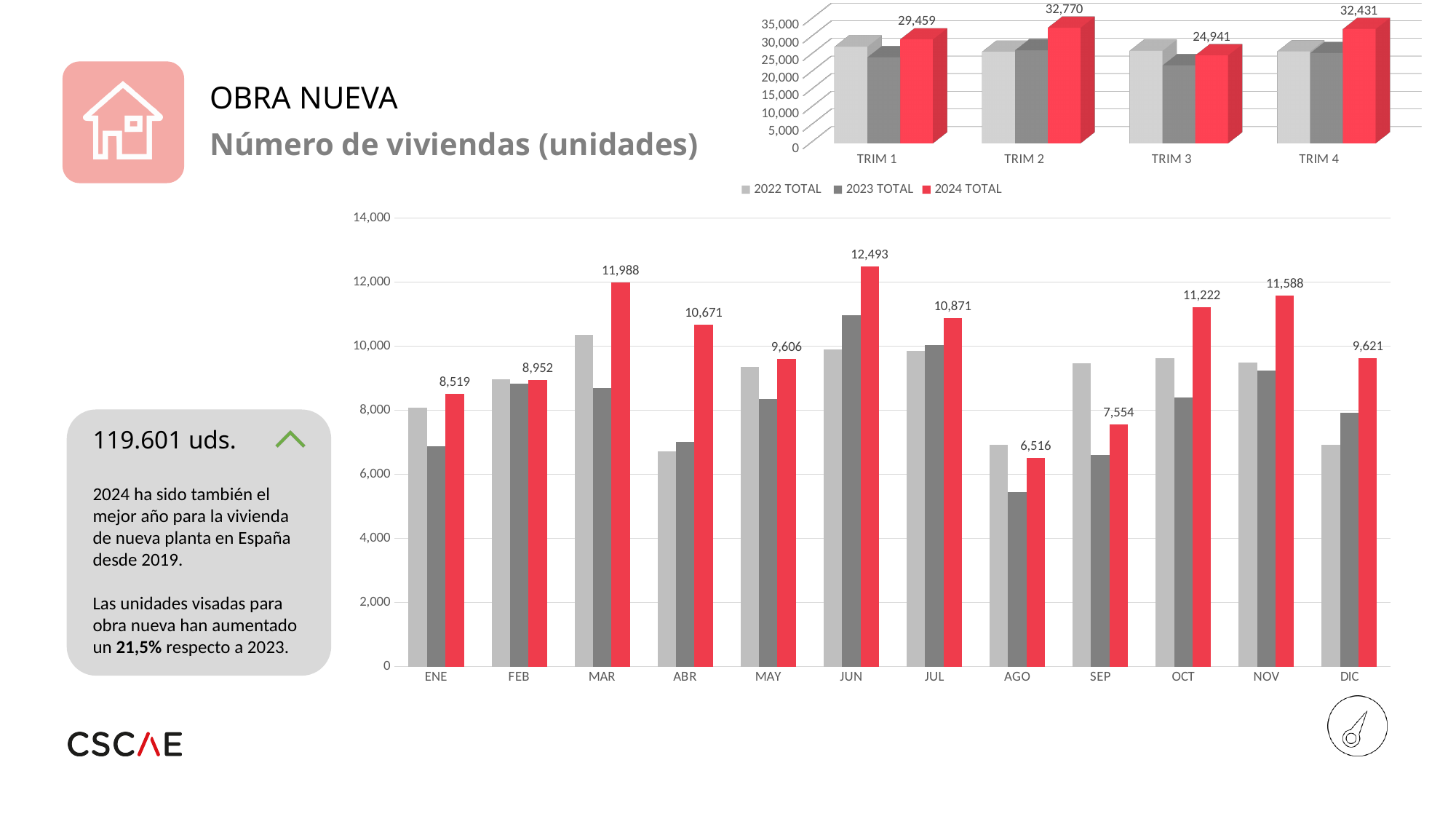
In the monthly chart at the bottom, which month has the larger 2024 TOTAL value, OCT or NOV? NOV In the monthly chart at the bottom, is the 2023 TOTAL value for JUN greater or less than 10,000? greater In the quarterly chart at the top right, what is the difference between the 2024 TOTAL values for TRIM 2 and TRIM 3? 7,829 How many series does the legend list for the charts on this slide? 3 In the monthly chart at the bottom, which month has the highest 2024 TOTAL value? JUN In the quarterly chart at the top right, which quarter has the highest 2024 TOTAL value? TRIM 2 In the monthly chart at the bottom, what is the 2024 TOTAL value for JUN? 12,493 How many months are shown on the x axis of the monthly chart at the bottom? 12 In the monthly chart at the bottom, what is the difference between the 2024 TOTAL values for MAR and ENE? 3,469 In the quarterly chart at the top right, what is the 2024 TOTAL value for TRIM 3? 24,941 In the monthly chart at the bottom, which month has the lowest 2024 TOTAL value? AGO What kind of chart is the monthly chart at the bottom of the slide? Bar chart